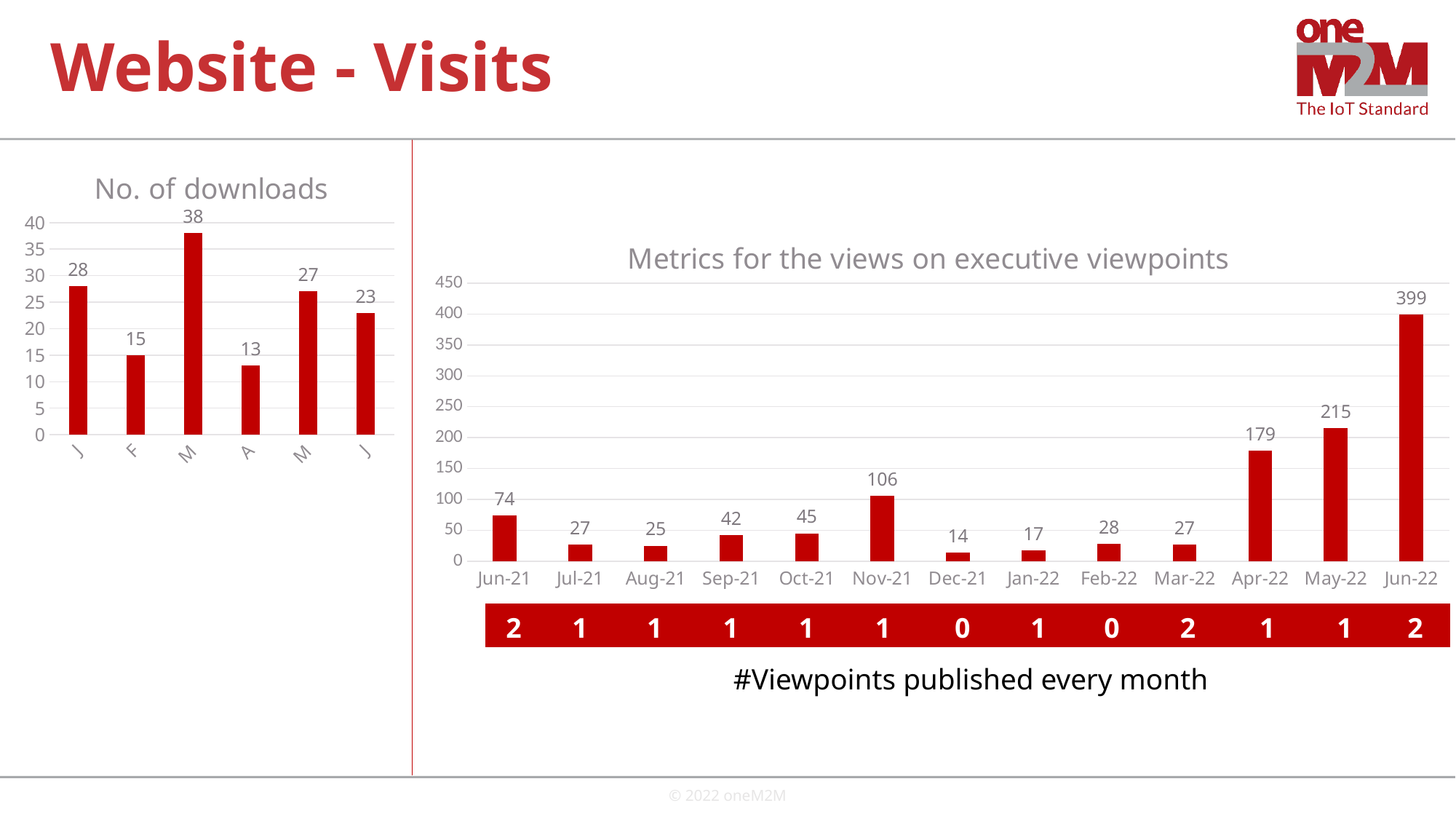
In the 'Metrics for the views on executive viewpoints' chart, which month has the lowest value? Dec-21 What kind of chart is the 'Metrics for the views on executive viewpoints' chart? Bar chart In the 'Metrics for the views on executive viewpoints' chart, what is the difference between the values for Jun-22 and May-22? 184 In the 'No. of downloads' chart, what is the value for F? 15 In the 'No. of downloads' chart, how many bars are plotted? 6 In the 'No. of downloads' chart, which category has the lowest value? A In the 'Metrics for the views on executive viewpoints' chart, which is larger, the value for Jun-21 or the value for Oct-21? Jun-21 In the 'Metrics for the views on executive viewpoints' chart, which month has the highest value? Jun-22 In the 'No. of downloads' chart, what is the highest value shown? 38 In the 'No. of downloads' chart, what is the value for A? 13 In the 'Metrics for the views on executive viewpoints' chart, what is the value for Nov-21? 106 In the 'Metrics for the views on executive viewpoints' chart, what is the value for May-22? 215